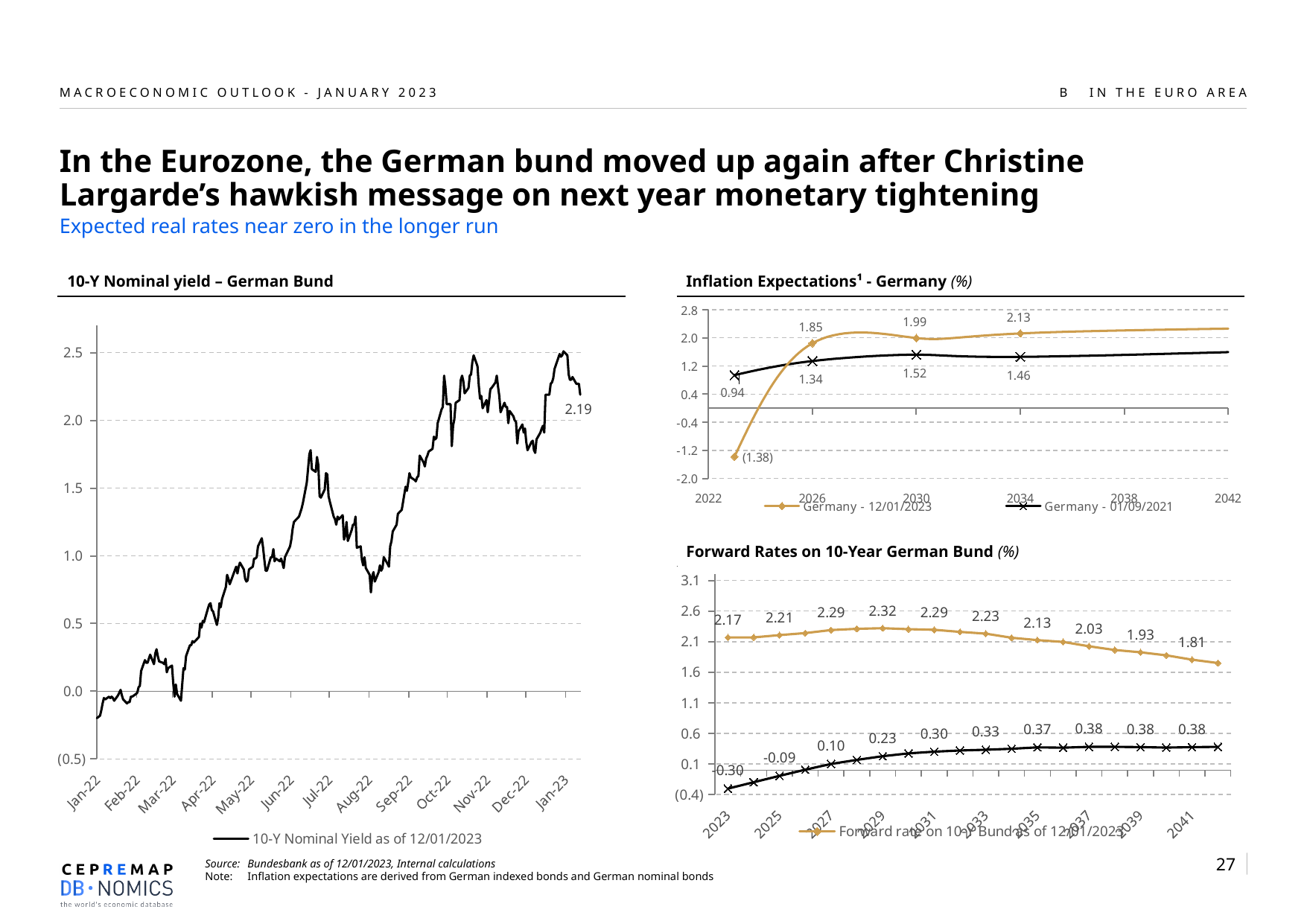
In the 'Inflation Expectations - Germany' chart, what is the first labeled value for the 'Germany - 01/09/2021' series? 0.94 In the '10-Y Nominal yield – German Bund' chart, does the yield overall rise or fall from Jan-22 to Jan-23? rise In the '10-Y Nominal yield – German Bund' chart, is the yield at the start of Jan-22 greater or less than 0.5? less In the 'Inflation Expectations - Germany' chart, at the third labeled point, which series is higher: 'Germany - 12/01/2023' (1.99) or 'Germany - 01/09/2021' (1.52)? Germany - 12/01/2023 In the 'Inflation Expectations - Germany' chart, what is the difference between the last labeled values of the two series, 2.13 and 1.46? 0.67 In the '10-Y Nominal yield – German Bund' chart, what is the legend entry? 10-Y Nominal Yield as of 12/01/2023 In the 'Forward Rates on 10-Year German Bund' chart, what is the highest labeled value of the 'Forward rate on 10-Y Bund as of 12/01/2023' series? 2.32 In the 'Inflation Expectations - Germany' chart, what is the highest labeled value for the 'Germany - 12/01/2023' series? 2.13 In the 'Forward Rates on 10-Year German Bund' chart, what is the difference between the highest (2.32) and lowest (1.81) labeled values of the 'Forward rate on 10-Y Bund as of 12/01/2023' series? 0.51 What kind of chart is the '10-Y Nominal yield – German Bund' chart? line chart In the '10-Y Nominal yield – German Bund' chart, what is the value printed at the end of the line in Jan-23? 2.19 How many series does the legend of the 'Inflation Expectations - Germany' chart list? 2